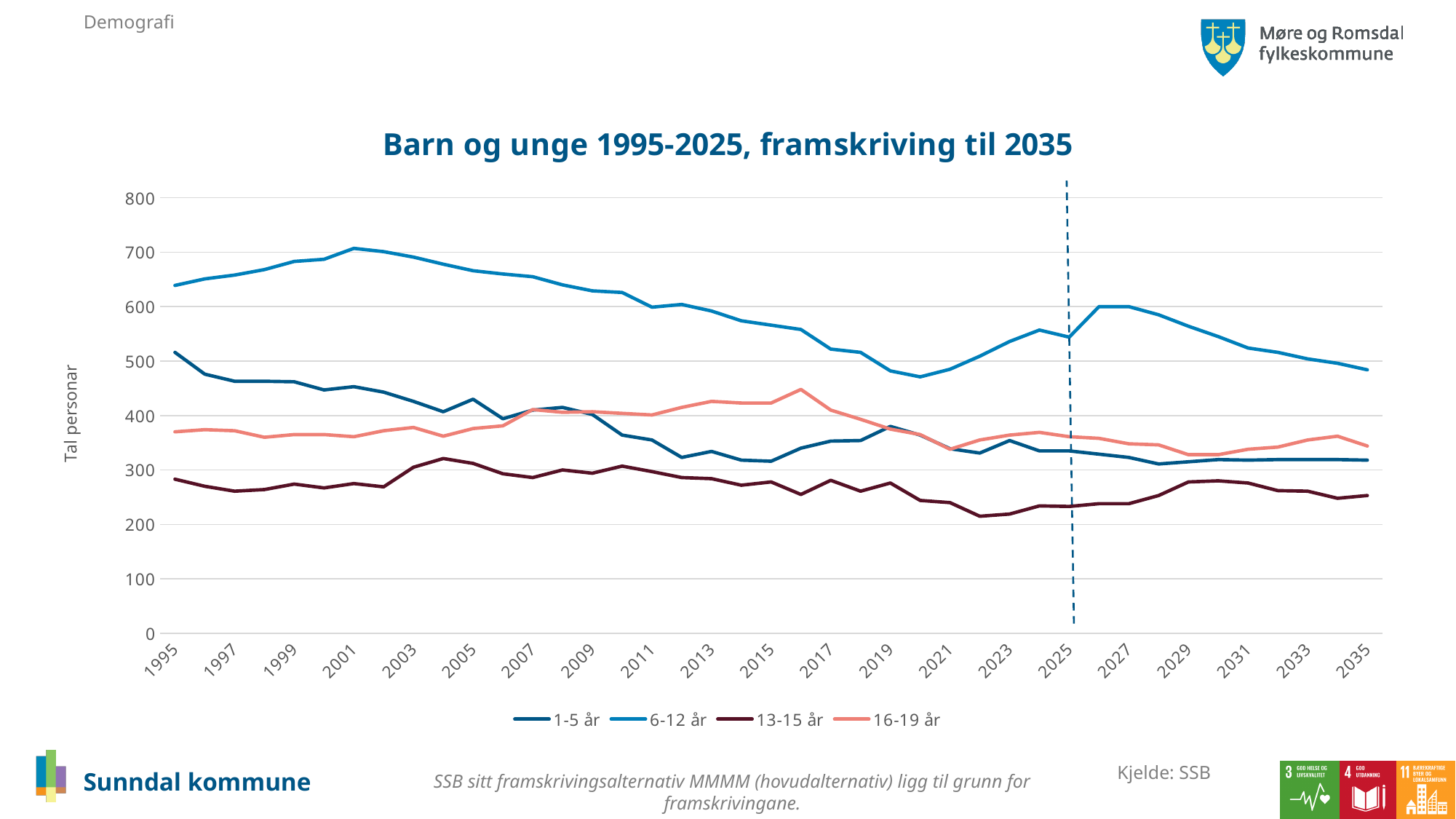
What is the label on the vertical axis? Tal personar How many series does the legend list? 4 Which series has the lowest value in 2035? 13-15 år Is the value for 13-15 år in 2022 greater or less than 250? less In 1995, which is larger: the value for 1-5 år or the value for 16-19 år? 1-5 år In 2016, which is larger: the value for 16-19 år or the value for 1-5 år? 16-19 år What is the title of the chart? Barn og unge 1995-2025, framskriving til 2035 Is the value for 6-12 år in 2020 greater or less than 500? less What kind of chart is shown on the slide? line chart Which series has the highest value in 1995? 6-12 år Is the value for 6-12 år in 2001 greater or less than 650? greater Does the 6-12 år series rise or fall between 1995 and 2020? fall